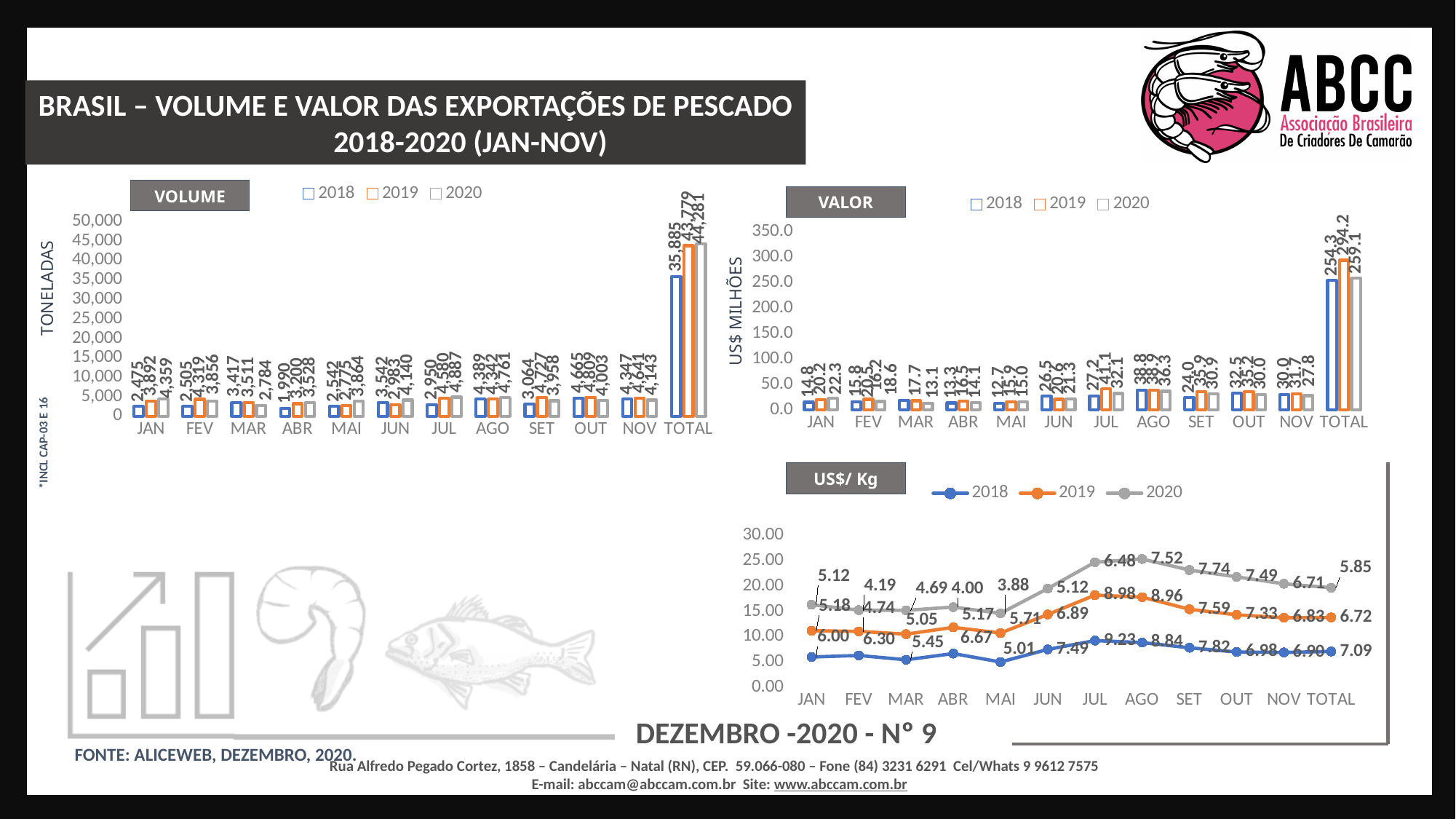
How many categories are shown on the x axis of the VOLUME chart? 12 In the VOLUME chart, what is the difference between the 2019 TOTAL and the 2018 TOTAL? 7,894 How many series does the legend of the US$/Kg chart list? 3 In the VALOR chart, which month has the highest value for 2019 (excluding TOTAL)? JUL In the VOLUME chart, what is the TOTAL value for 2020? 44,281 What kind of chart is the VOLUME chart? bar chart In the VALOR chart, what is the TOTAL value for 2019? 294.2 In the VALOR chart, what is the value for 2019 in JUL? 41.1 In the US$/Kg chart, what is the TOTAL value for 2018? 7.09 In the VOLUME chart, which year has the highest TOTAL? 2020 In the VALOR chart, which is larger in JUN: the 2018 value or the 2019 value? 2018 In the VOLUME chart, what is the value for 2018 in JAN? 2,475